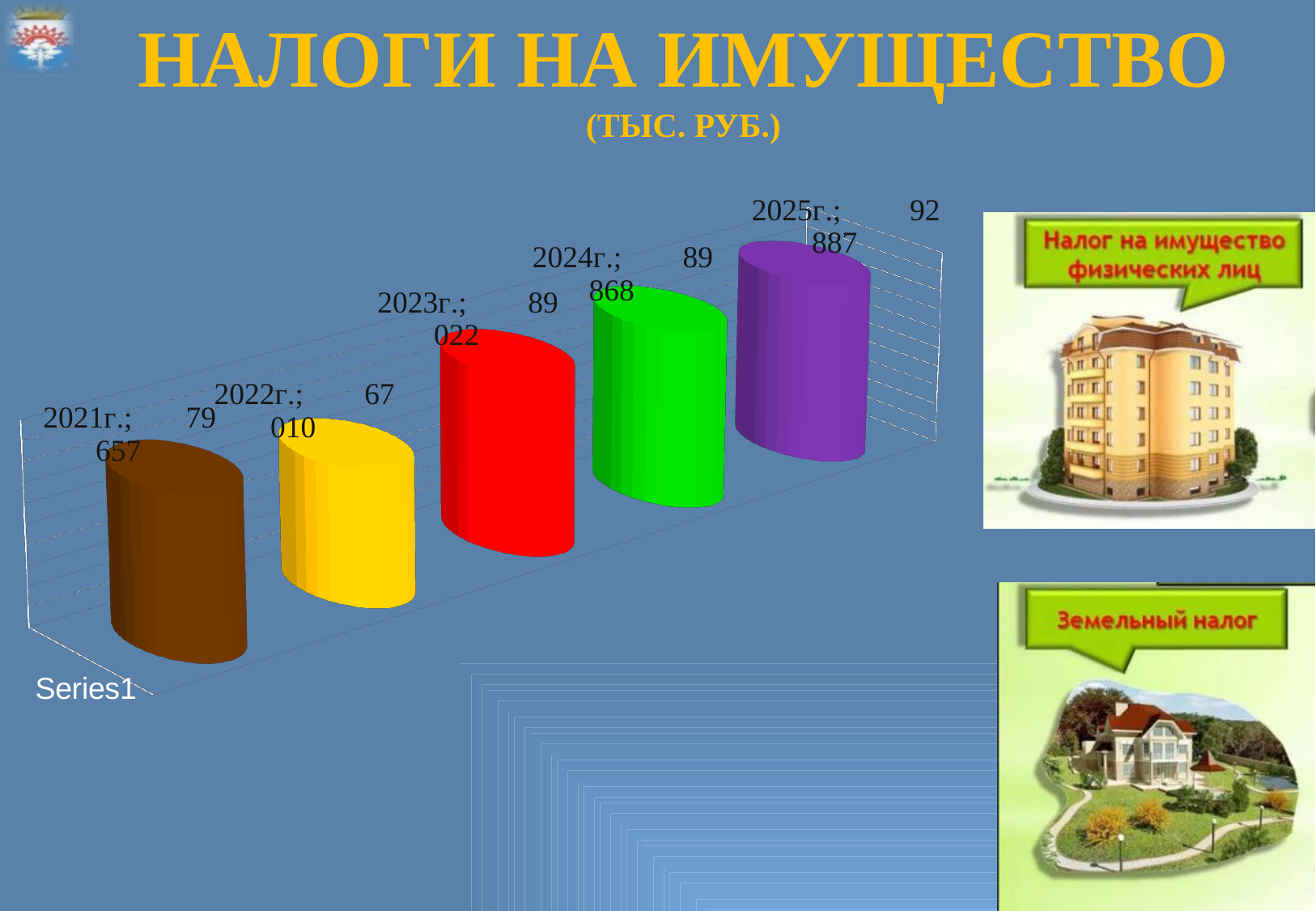
What is the value for 2022г. on the chart? 67 010 What is the difference between the values for 2024г. and 2023г.? 846 How many years are shown on the chart? 5 How many series does the chart legend list? 1 What is the difference between the values for 2025г. and 2021г.? 13 230 Which year has the lowest value on the chart? 2022г. What is the value for 2021г. on the chart? 79 657 Do the values rise or fall from 2022г. to 2025г.? rise Which year has the highest value on the chart? 2025г. What is the value for 2025г. on the chart? 92 887 Which is larger, the value for 2021г. or the value for 2022г.? 2021г. What kind of chart is shown on the slide? bar chart